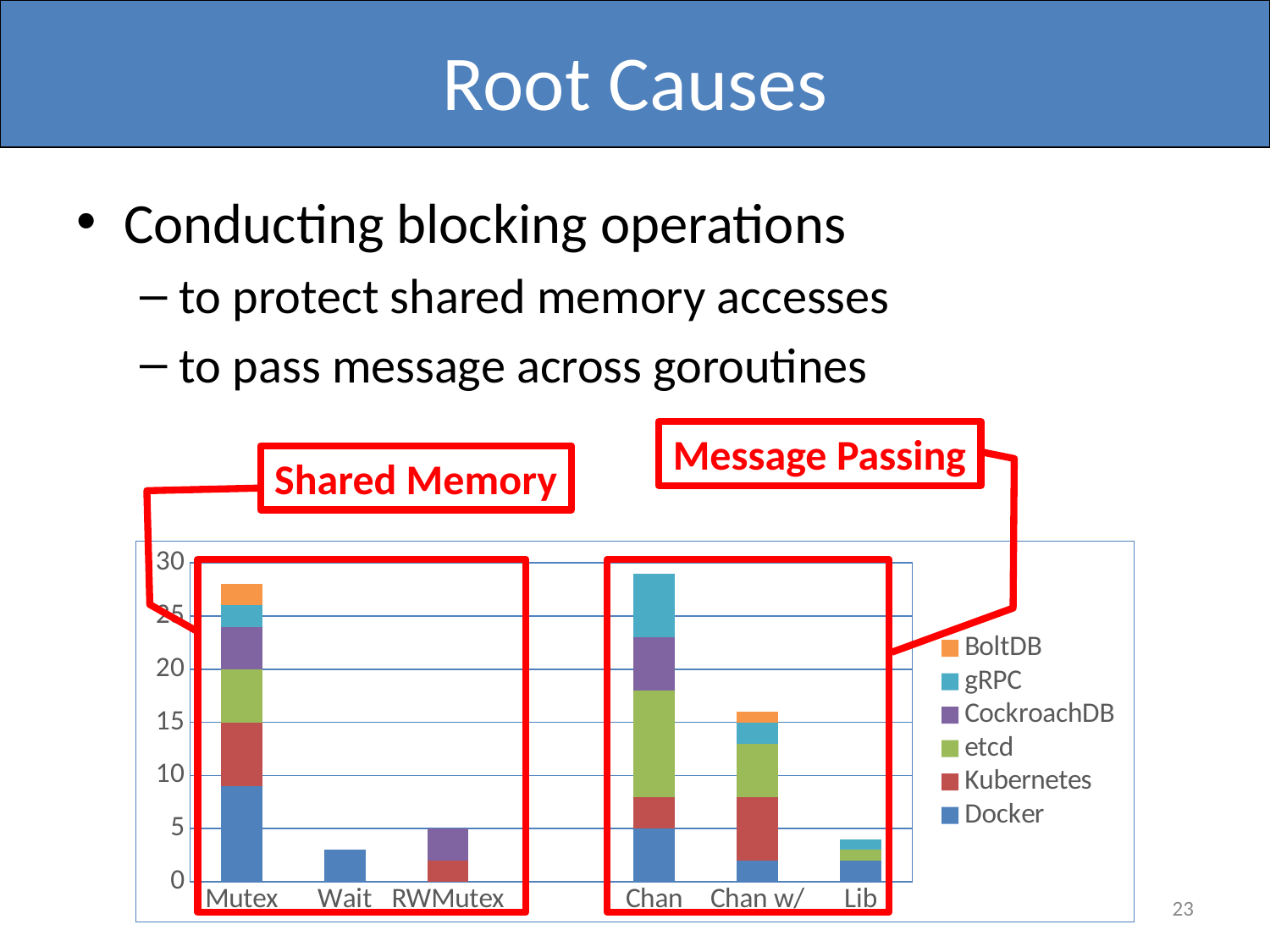
What kind of chart is shown on the slide? stacked bar chart Which has the larger total bar, Chan w/ or Lib? Chan w/ Which series is listed first (at the top) in the chart legend? BoltDB Which categories are grouped under the 'Shared Memory' label? Mutex, Wait, RWMutex Which has the larger total bar, Mutex or Wait? Mutex Is the total value for Chan greater or less than 25? greater How many categories are shown along the x axis of the chart? 6 Is the total value for Chan w/ greater or less than 10? greater Is the total value for RWMutex greater or less than 10? less How many series does the chart legend list? 6